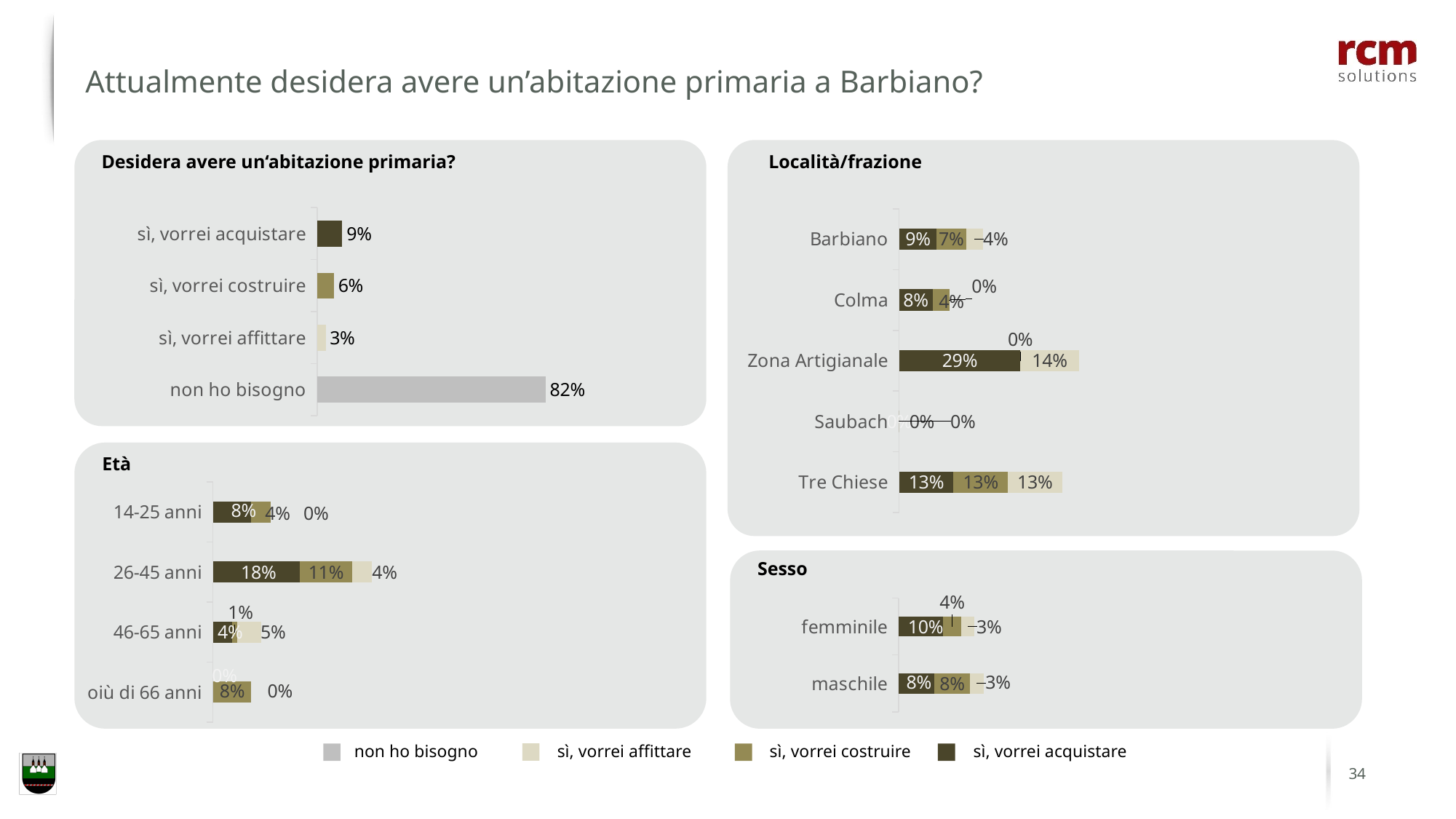
What type of chart is the 'Età' chart? bar chart In the chart 'Età', which age group has the highest 'sì, vorrei acquistare' value? 26-45 anni In the chart 'Sesso', what is the 'sì, vorrei affittare' value for maschile? 3% In the chart 'Località/frazione', what is the 'sì, vorrei acquistare' value for Zona Artigianale? 29% In the chart 'Desidera avere un'abitazione primaria?', which category has the lowest value? sì, vorrei affittare In the chart 'Sesso', which is larger: the 'sì, vorrei acquistare' value for femminile or for maschile? femminile In the chart 'Località/frazione', what is the total of the stacked bar for Tre Chiese? 39% How many series does the legend at the bottom of the slide list? 4 In the chart 'Desidera avere un'abitazione primaria?', what is the difference between 'sì, vorrei acquistare' and 'sì, vorrei costruire'? 3% In the chart 'Età', what is the 'sì, vorrei costruire' value for 26-45 anni? 11% In the chart 'Desidera avere un'abitazione primaria?', what is the value for 'non ho bisogno'? 82% In the chart 'Località/frazione', how many località categories are shown? 5